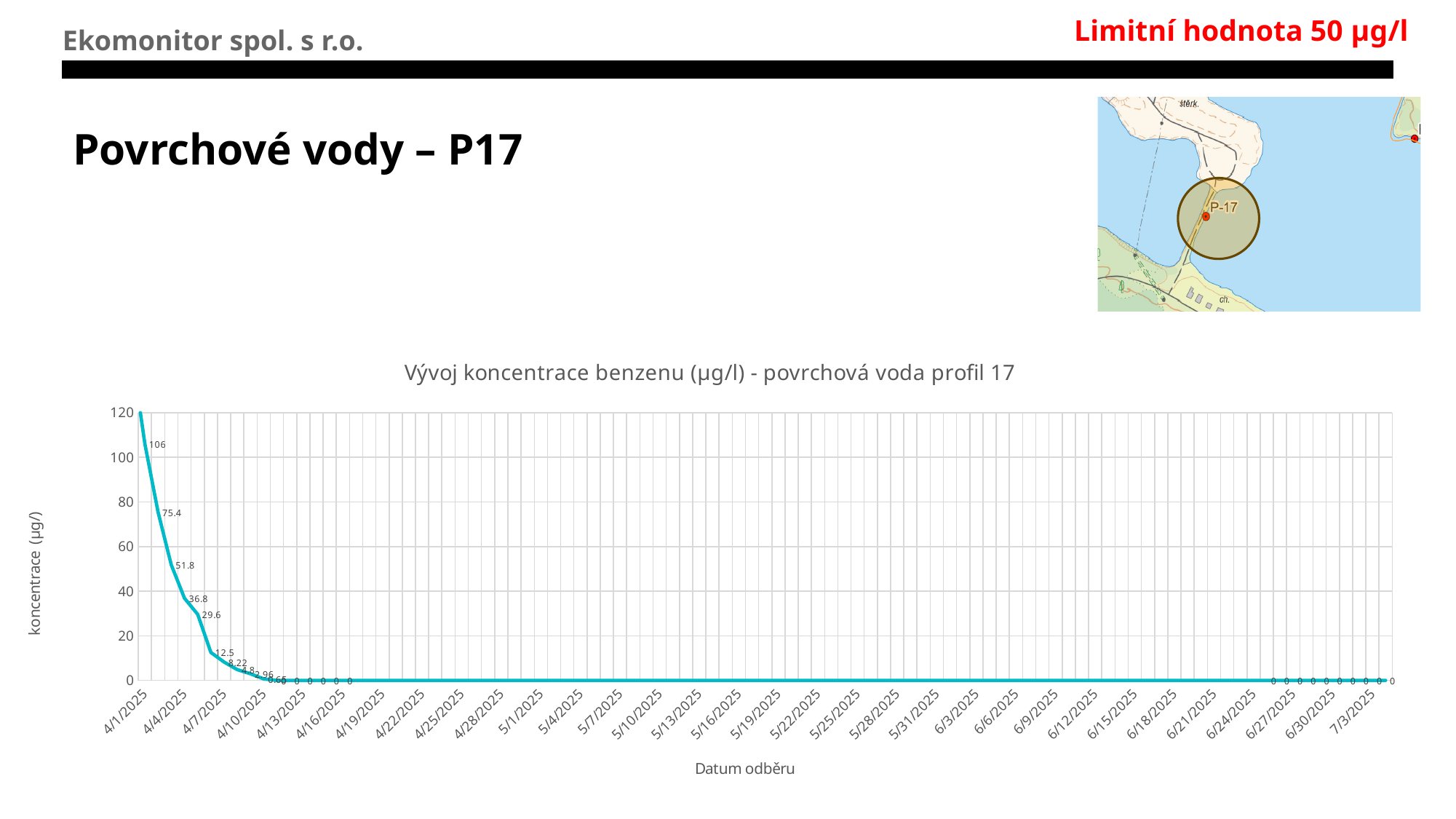
What is the label of the x axis of the chart? Datum odběru Is the value for 5/1/2025 greater or less than 20? less Is the value for 4/1/2025 greater or less than 100? greater Which labeled value is larger, 51.8 or 36.8? 51.8 Is the value for 4/4/2025 greater or less than 20? greater What kind of chart is shown on the slide? line chart What is the title of the chart? Vývoj koncentrace benzenu (µg/l) - povrchová voda profil 17 Do the plotted values rise or fall over time along the x axis? fall What is the difference between the labeled values 106 and 75.4 on the chart? 30.6 On which date does the concentration reach its highest value? 4/1/2025 What is the highest value shown on the y axis of the chart? 120